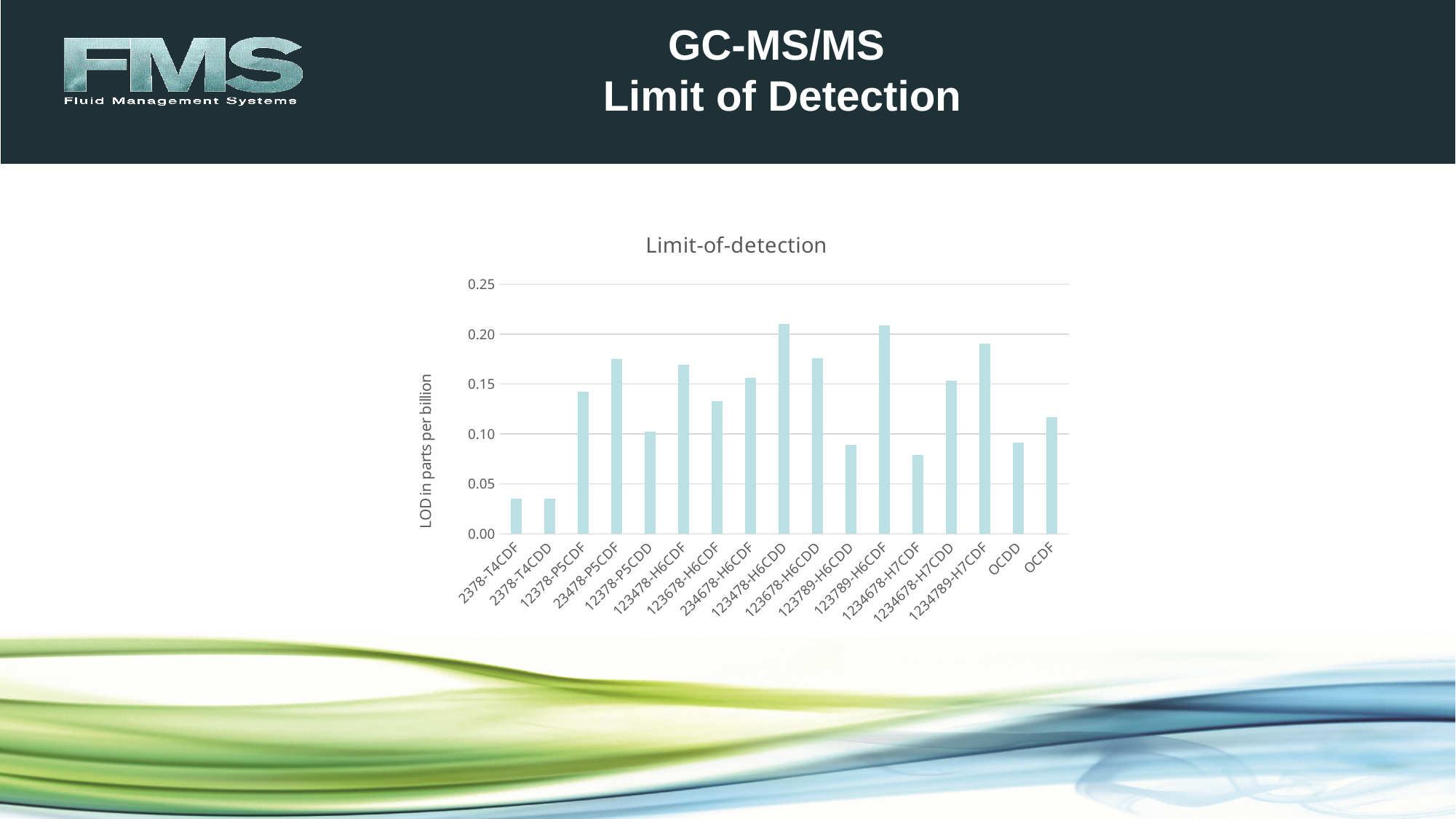
Which has the larger value, 23478-P5CDF or 12378-P5CDD? 23478-P5CDF Is the value for 1234678-H7CDF greater or less than 0.10? less Is the value for OCDF greater or less than 0.10? greater What kind of chart is shown on the slide? bar chart Which has the larger value, 1234789-H7CDF or OCDD? 1234789-H7CDF Is the value for 123478-H6CDD greater or less than 0.20? greater How many categories (bars) are plotted in the chart? 17 What is the label of the vertical axis? LOD in parts per billion What is the title of the chart? Limit-of-detection Which has the larger value, 2378-T4CDD or 12378-P5CDF? 12378-P5CDF